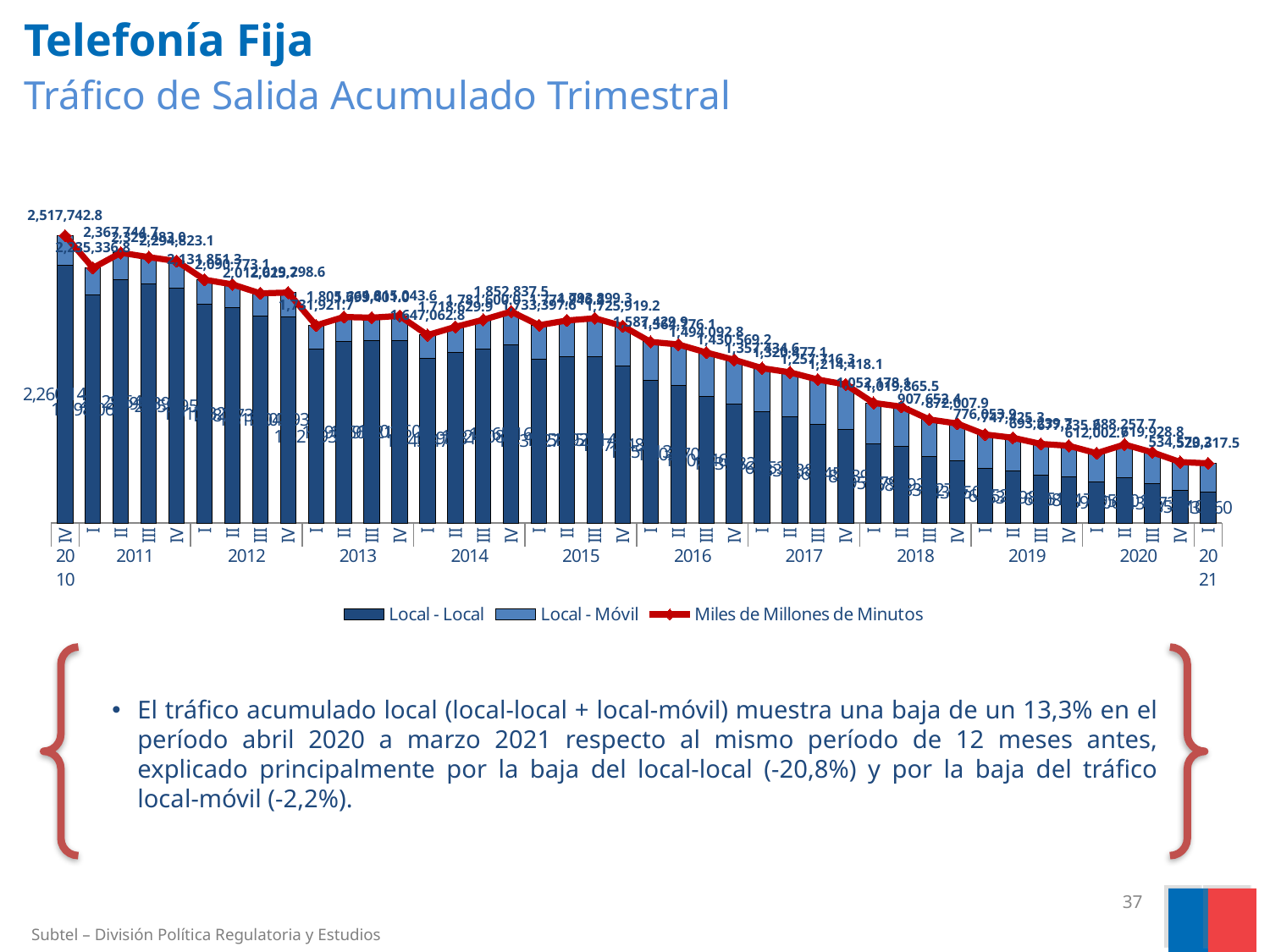
Which is larger, the line value at IV 2010 or the line value at I 2021? IV 2010 How many quarterly bars are plotted on the chart? 42 What kind of chart is shown on the slide? A stacked bar chart combined with a line chart What are the names of the series listed in the chart legend? Local - Local, Local - Móvil, Miles de Millones de Minutos At which quarter does the 'Miles de Millones de Minutos' line reach its highest value? IV 2010 In the IV 2010 bar, which segment is larger, Local - Local or Local - Móvil? Local - Local What is the value of the 'Miles de Millones de Minutos' line at IV 2010, the first point on the chart? 2,517,742.8 Which series is drawn as a red line with markers? Miles de Millones de Minutos How many series does the chart legend list? 3 At which quarter does the 'Miles de Millones de Minutos' line reach its lowest value? I 2021 Does the 'Miles de Millones de Minutos' line generally rise or fall from 2010 to 2021? Fall What is the subtitle of the chart on the slide? Tráfico de Salida Acumulado Trimestral